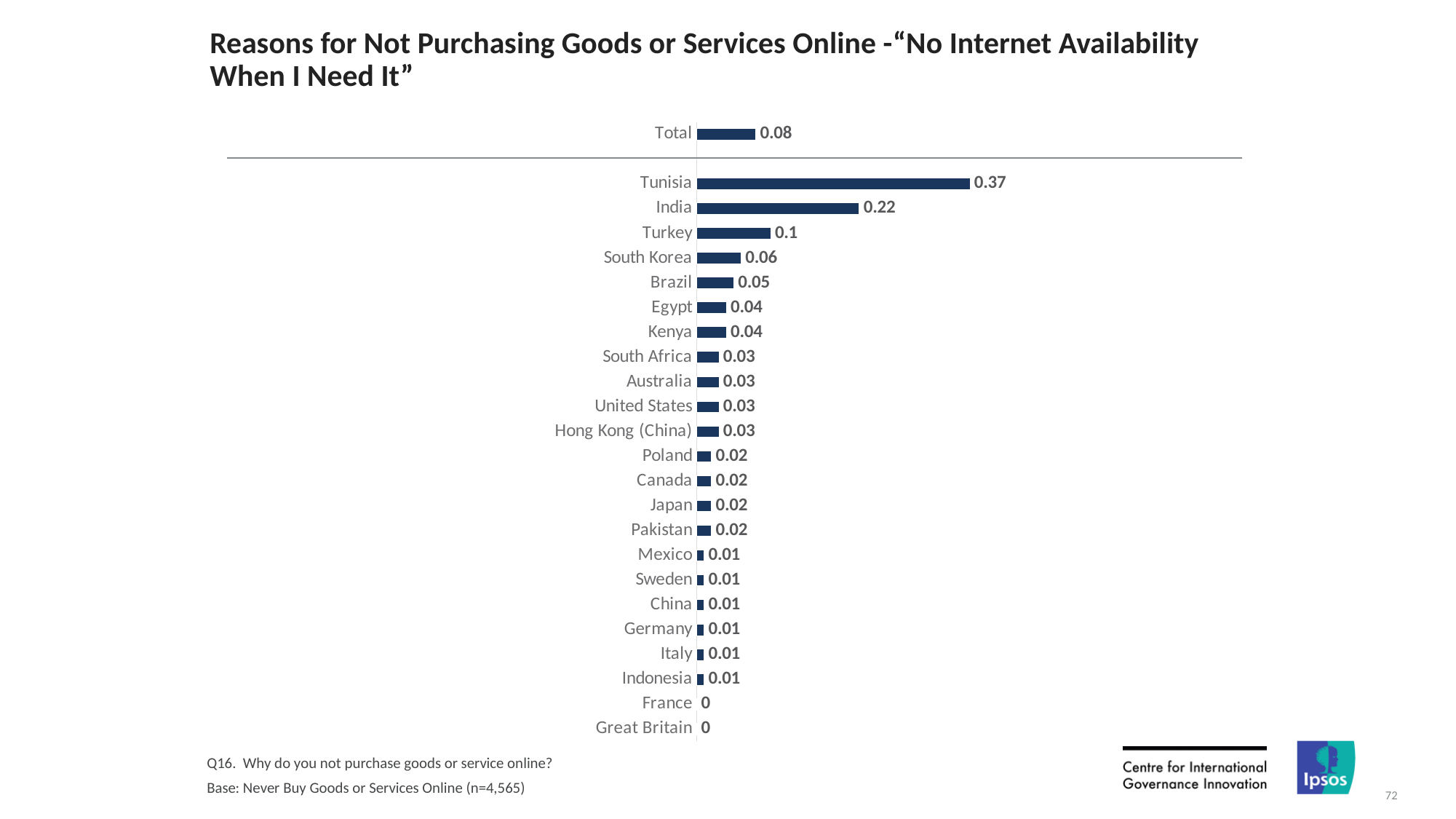
Which has a larger value, Brazil or Egypt? Brazil What is the value shown for Total? 0.08 What is the value for Great Britain? 0 Which country has the highest value? Tunisia What kind of chart is shown on the slide? Bar chart How many countries are listed below the Total bar? 23 What is the difference between the values for Tunisia and India? 0.15 What is the difference between the values for Turkey and South Korea? 0.04 What is the value for India? 0.22 What is the value for Tunisia? 0.37 What is the value for Turkey? 0.1 Which has a larger value, India or Turkey? India